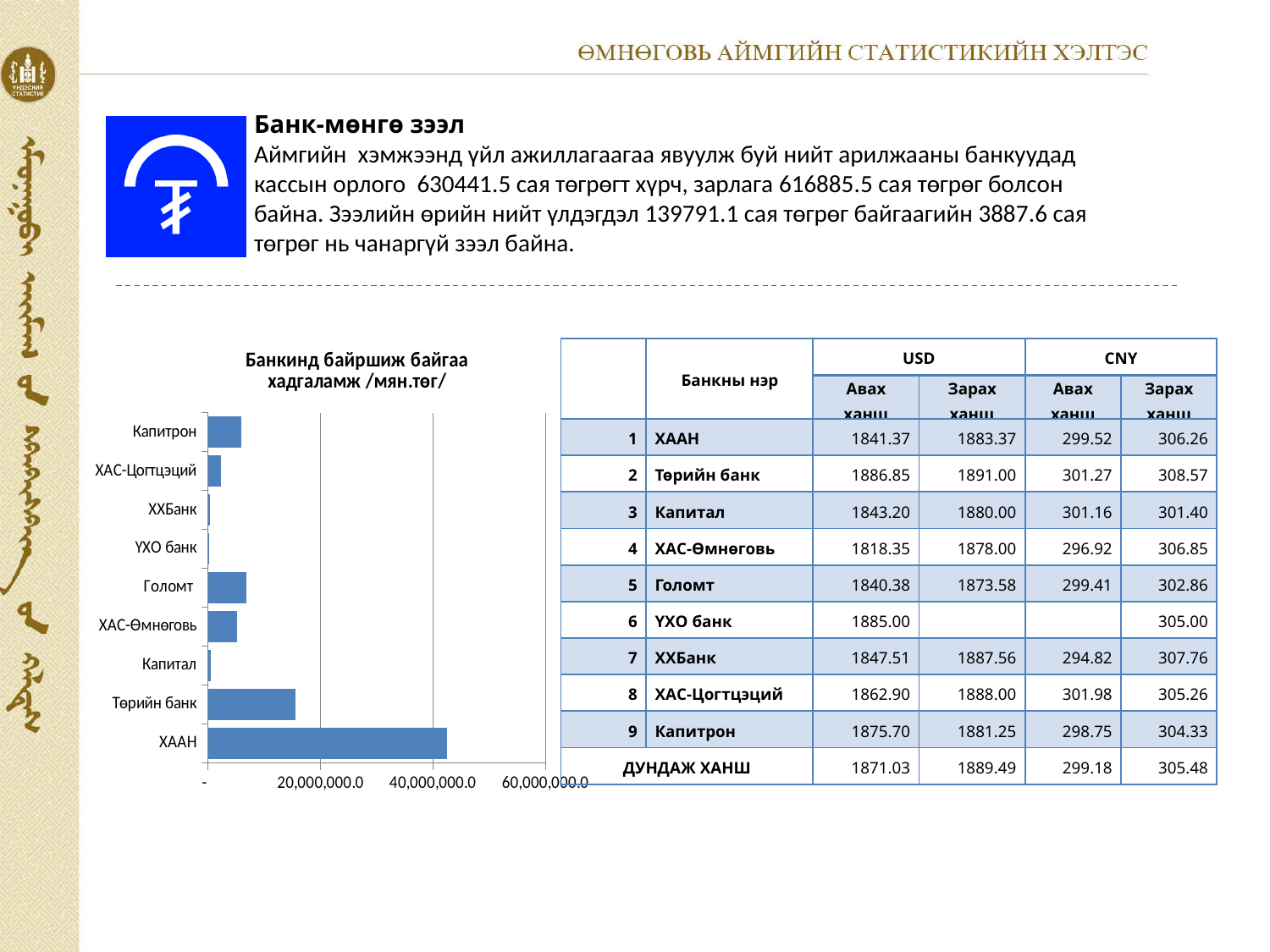
Which bank has the second-highest value in the bar chart? Төрийн банк Is the value for ХААН greater or less than 20,000,000.0? greater Which bank has the highest value in the bar chart? ХААН What kind of chart is shown on the slide? bar chart How many banks (categories) are shown in the bar chart? 9 Which is larger, the value for Голомт or the value for Капитал? Голомт Is the value for Голомт greater or less than 20,000,000.0? less Is the value for Төрийн банк greater or less than 20,000,000.0? less Which is larger, the value for ХААН or the value for Төрийн банк? ХААН Which is larger, the value for Капитрон or the value for ХАС-Цогтцэций? Капитрон What colour are the bars in the chart? blue What is the title of the bar chart? Банкинд байршиж байгаа хадгаламж /мян.төг/